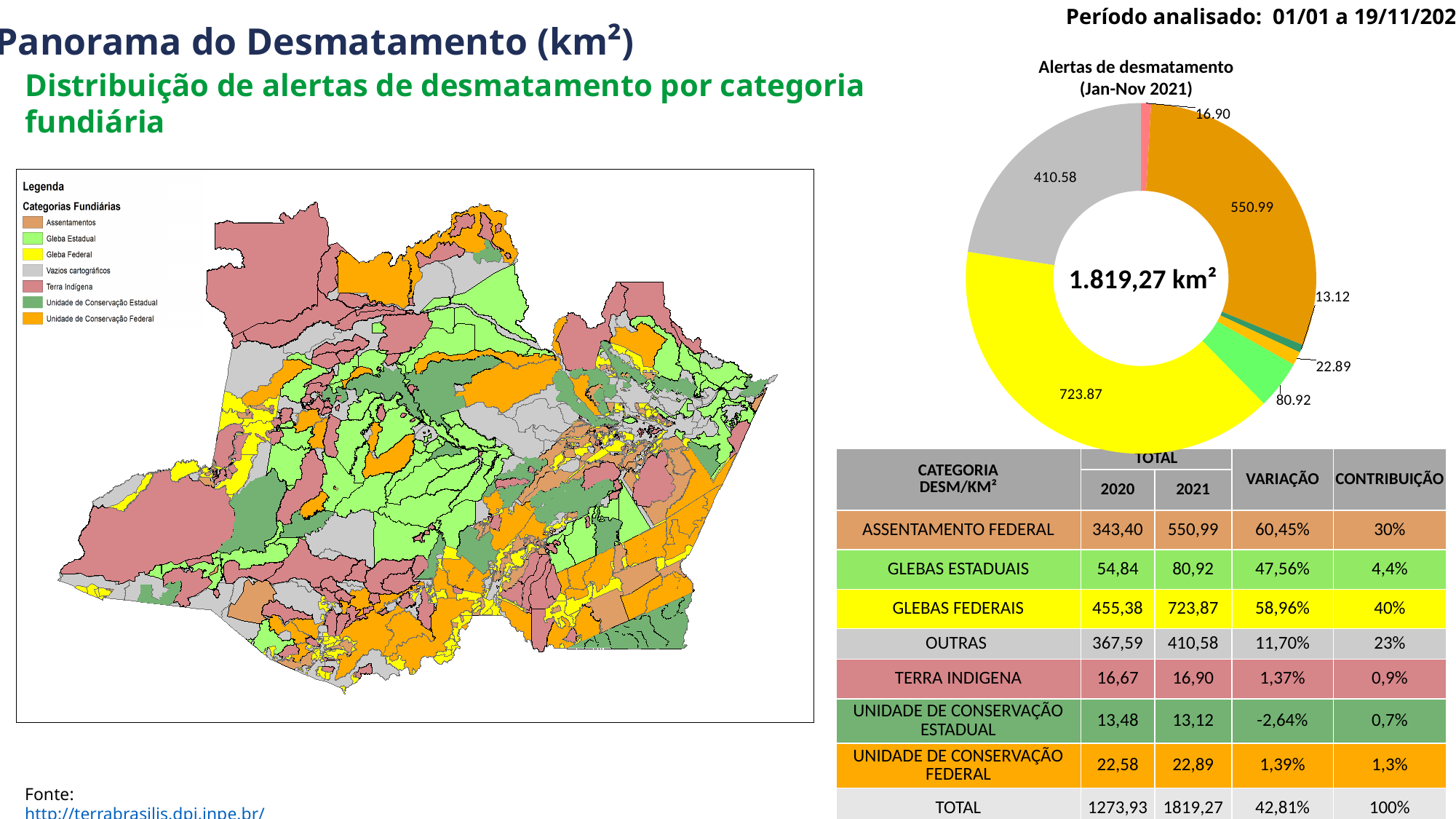
In the 'Alertas de desmatamento (Jan-Nov 2021)' chart, which is larger: the orange-brown slice (550.99) or the grey slice (410.58)? The orange-brown slice (550.99) What total value is printed in the centre of the 'Alertas de desmatamento (Jan-Nov 2021)' donut chart? 1.819,27 km² In the 'Alertas de desmatamento (Jan-Nov 2021)' chart, what is the difference between the yellow slice (723.87) and the orange-brown slice (550.99)? 172.88 In the 'Alertas de desmatamento (Jan-Nov 2021)' chart, what value is shown for the grey slice (Outras)? 410.58 How many slices does the 'Alertas de desmatamento (Jan-Nov 2021)' donut chart have? 7 In the 'Alertas de desmatamento (Jan-Nov 2021)' chart, what value is shown for the light green slice (Glebas Estaduais)? 80.92 In the 'Alertas de desmatamento (Jan-Nov 2021)' chart, what value is shown for the yellow slice (Glebas Federais)? 723.87 In the 'Alertas de desmatamento (Jan-Nov 2021)' chart, what is the difference between the slices labelled 22.89 and 16.90? 5.99 What is the title of the donut chart on the right of the slide? Alertas de desmatamento (Jan-Nov 2021) What is the value of the largest slice in the 'Alertas de desmatamento (Jan-Nov 2021)' chart? 723.87 What kind of chart is 'Alertas de desmatamento (Jan-Nov 2021)'? Donut (pie) chart What is the value of the smallest slice in the 'Alertas de desmatamento (Jan-Nov 2021)' chart? 13.12